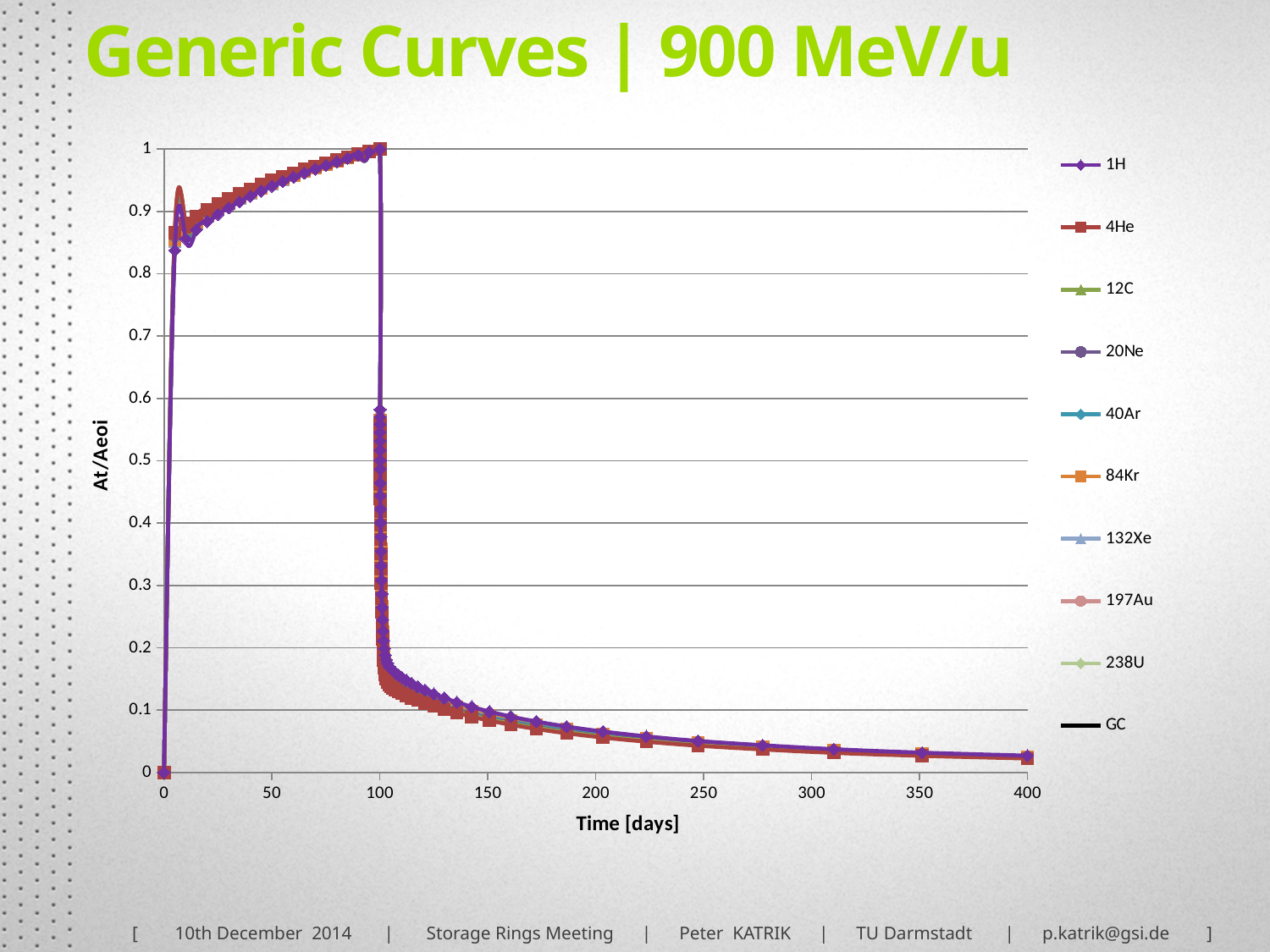
What is the maximum value reached by the curves on the y axis? 1 Do the curves rise or fall between 20 and 100 days? rise Do the curves rise or fall between 150 and 400 days? fall Is the value of the curves at 200 days greater or less than 0.1? less Is the value of the curves at 400 days greater or less than 0.1? less Is the value of the curves at 50 days greater or less than 0.9? greater What is the title of the chart on the slide? Generic Curves | 900 MeV/u At what time in days do the curves reach their peak value? 100 What kind of chart is shown on the slide? line chart How many series does the legend list? 10 What is the label of the x axis? Time [days]